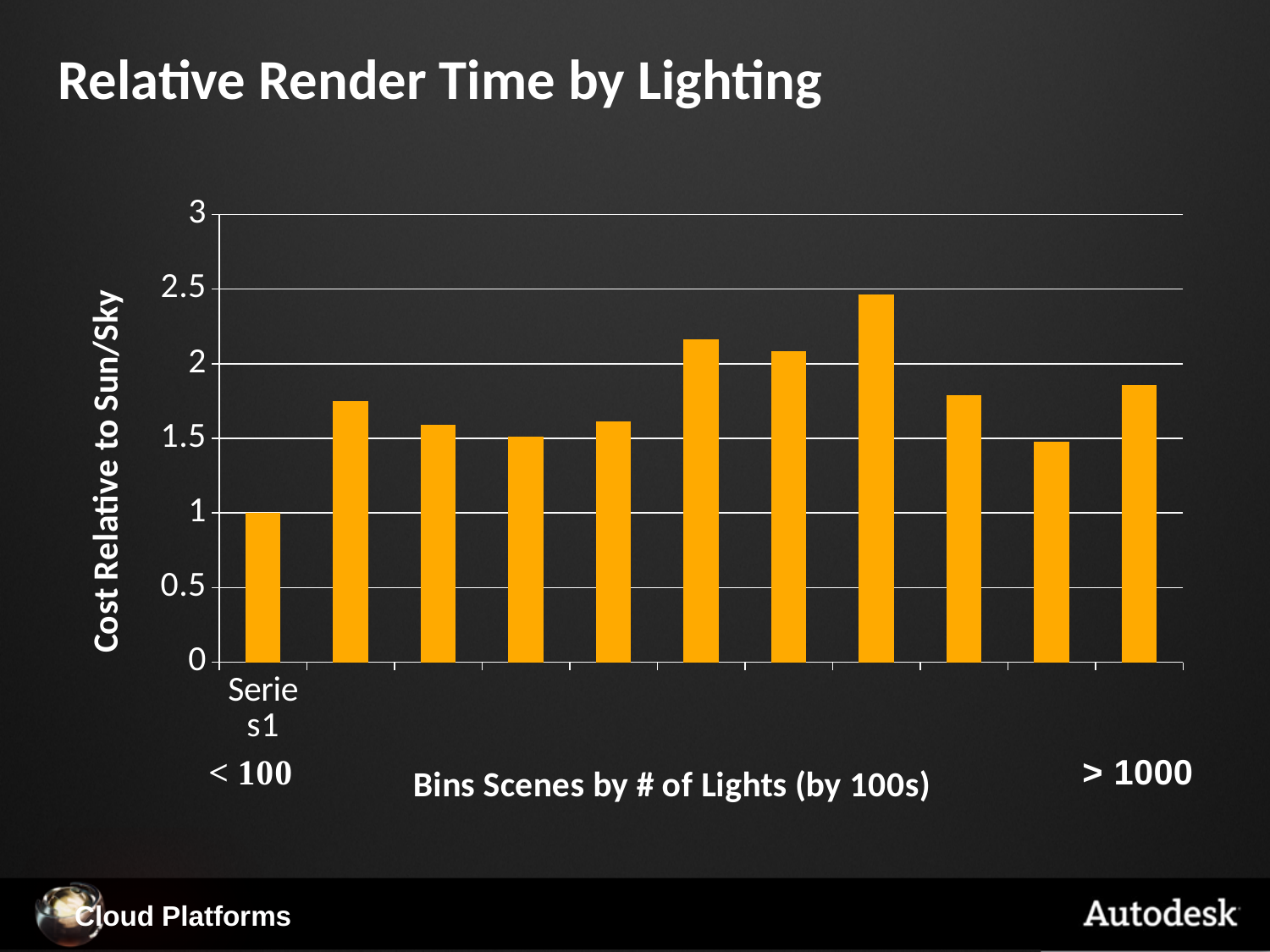
What is the title of the chart? Relative Render Time by Lighting What is the value of the first bar (Series1, the < 100 lights bin)? 1 How many bars are plotted in the chart? 11 Which bar has the highest value in the chart? the eighth bar from the left Which is larger, the value of the first bar or the value of the second bar? the second bar Is the value of the eighth bar from the left greater or less than 2? greater What kind of chart is shown on the slide? bar chart Is the value of the sixth bar from the left greater or less than 2? greater Is the value of the second bar from the left greater or less than 1.5? greater Which bar has the lowest value in the chart? the first bar (Series1, < 100 lights) What is the label on the vertical axis of the chart? Cost Relative to Sun/Sky